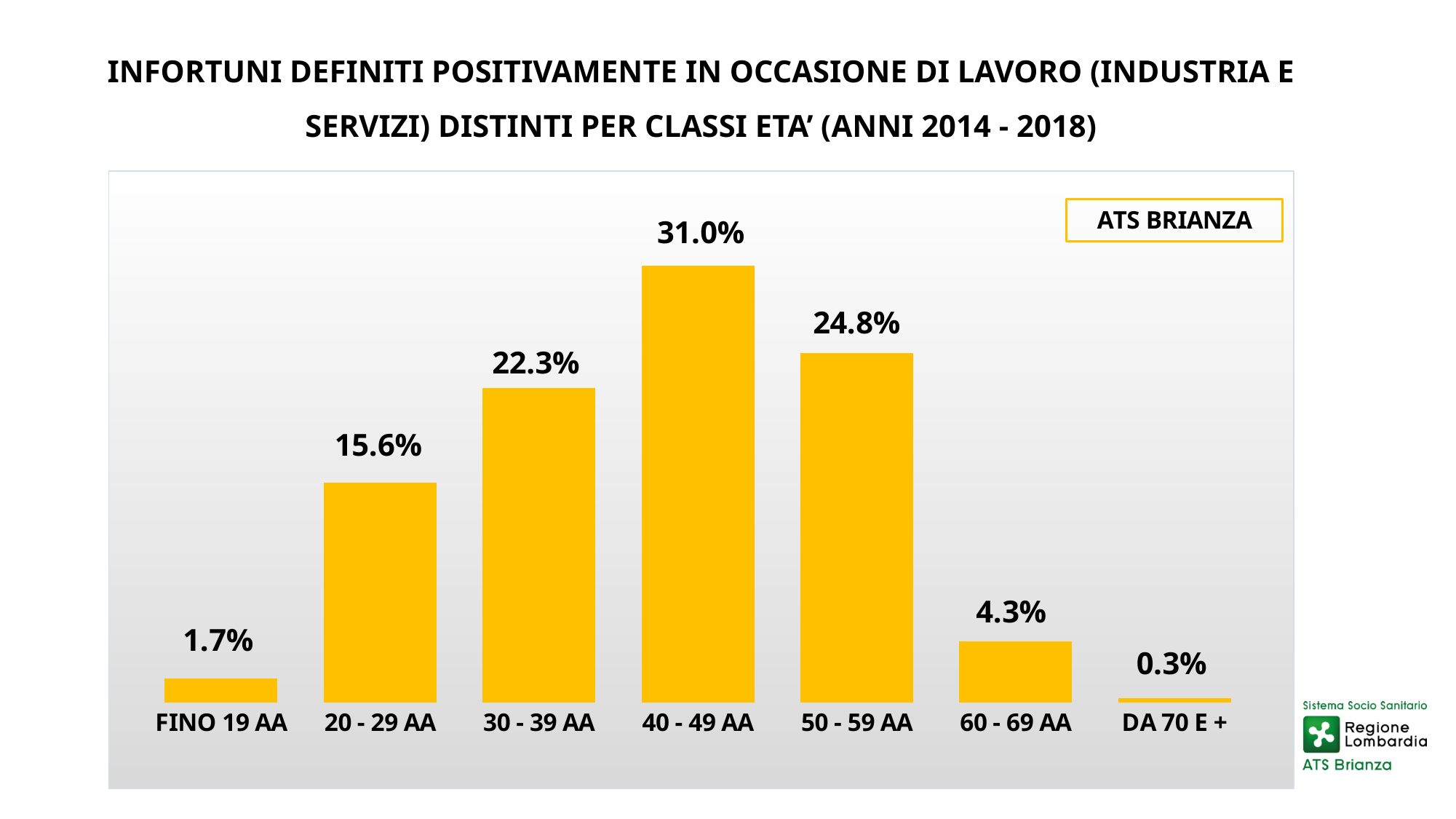
Which is larger, the value for 50 - 59 AA or the value for 30 - 39 AA? 50 - 59 AA What is the value for the FINO 19 AA age class? 1.7% What label appears in the box at the top right of the chart? ATS BRIANZA What is the difference between the values for 40 - 49 AA and 50 - 59 AA? 6.2% How many age classes are shown on the chart? 7 Which age class has the highest value? 40 - 49 AA What is the value for the 60 - 69 AA age class? 4.3% What kind of chart is shown on the slide? bar chart Which age class has the lowest value? DA 70 E + Do the values rise or fall from 40 - 49 AA to DA 70 E + along the x axis? fall What is the value for the 40 - 49 AA age class? 31.0% What is the difference between the values for 30 - 39 AA and 20 - 29 AA? 6.7%